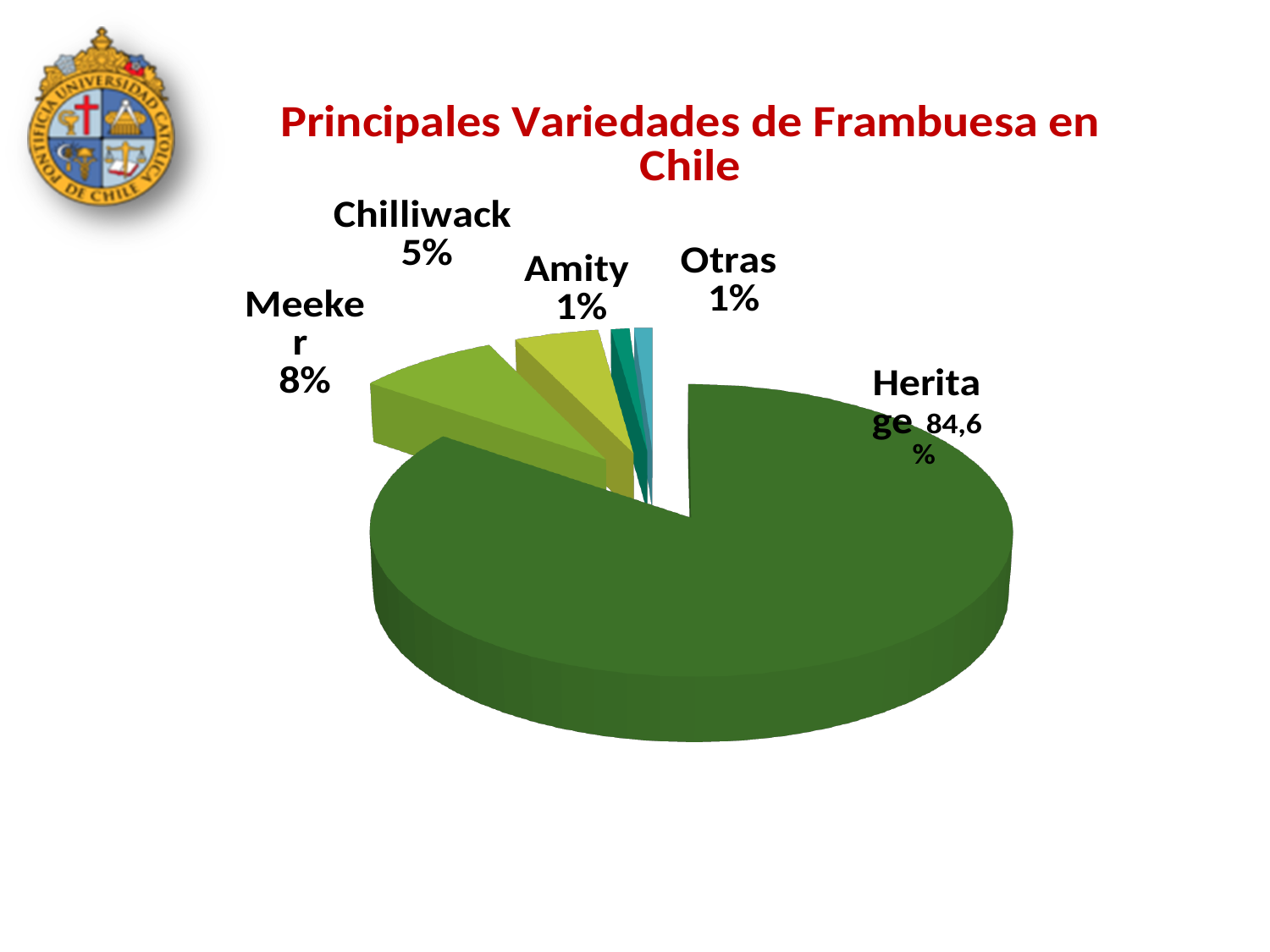
What colour is the Heritage slice? Dark green What is the value shown for Meeker? 8% What kind of chart is shown on the slide? Pie chart How many slices does the pie chart have? 5 Which is larger, the slice for Meeker or the slice for Chilliwack? Meeker What is the value shown for Otras? 1% What is the title of the chart? Principales Variedades de Frambuesa en Chile What share of the pie does Heritage represent? 84,6% What is the value shown for Amity? 1% Which variety has the largest slice of the pie? Heritage What is the difference between the Meeker and Chilliwack percentages? 3% What is the value shown for Chilliwack? 5%